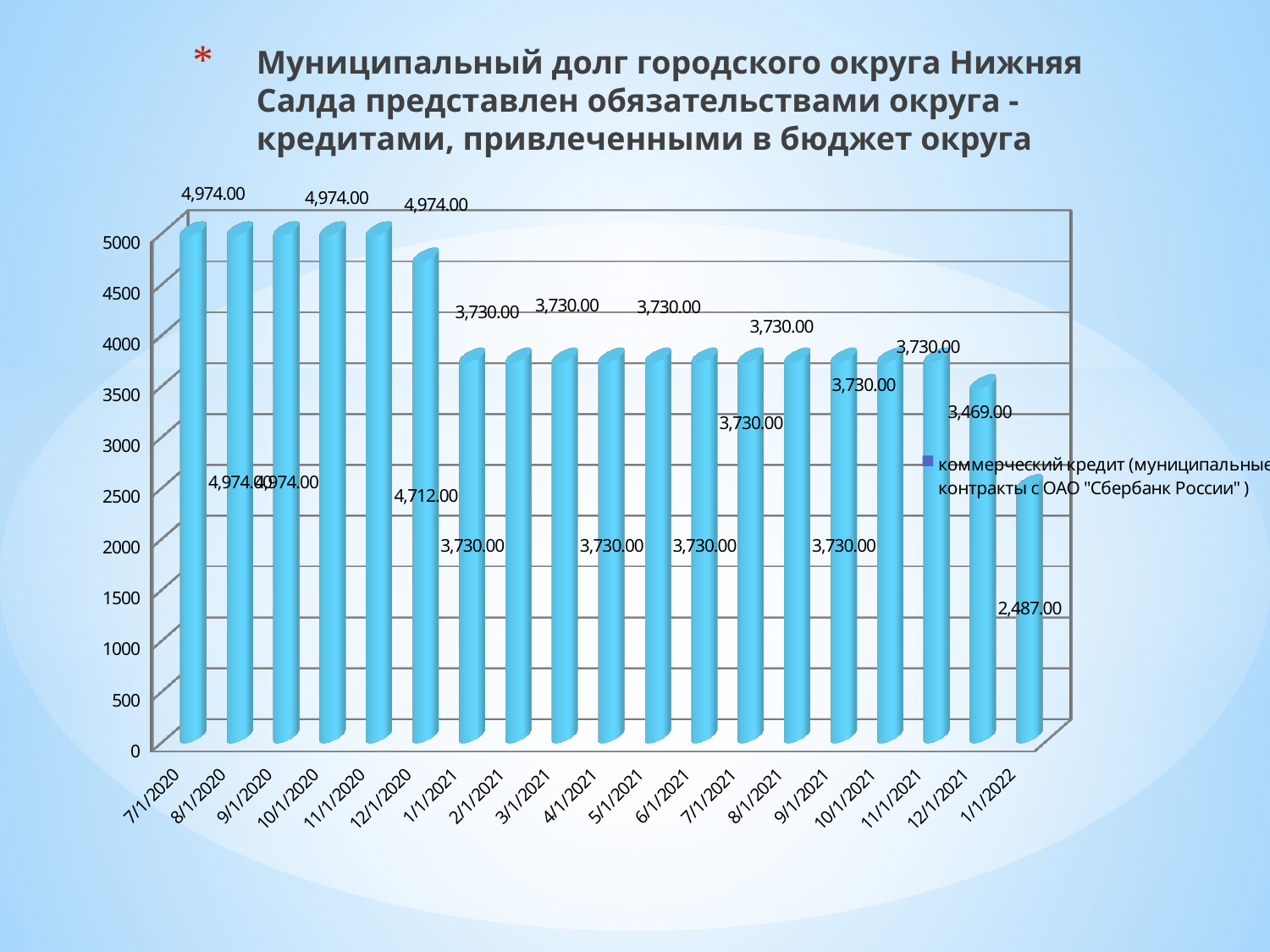
What is the value for 5/1/2021? 3,730.00 Is the value for 1/1/2022 greater or less than 3000? less What is the difference between the values for 12/1/2020 and 1/1/2021? 982.00 What is the value for 12/1/2020? 4,712.00 Which is larger, the value for 12/1/2020 or the value for 12/1/2021? 12/1/2020 What is the difference between the values for 7/1/2020 and 1/1/2022? 2,487.00 Which date has the lowest value? 1/1/2022 What is the value for 12/1/2021? 3,469.00 Do the values rise or fall from 7/1/2020 to 1/1/2022? fall How many series does the legend list? 1 What is the value for 1/1/2022? 2,487.00 How many dates are shown on the x axis? 19